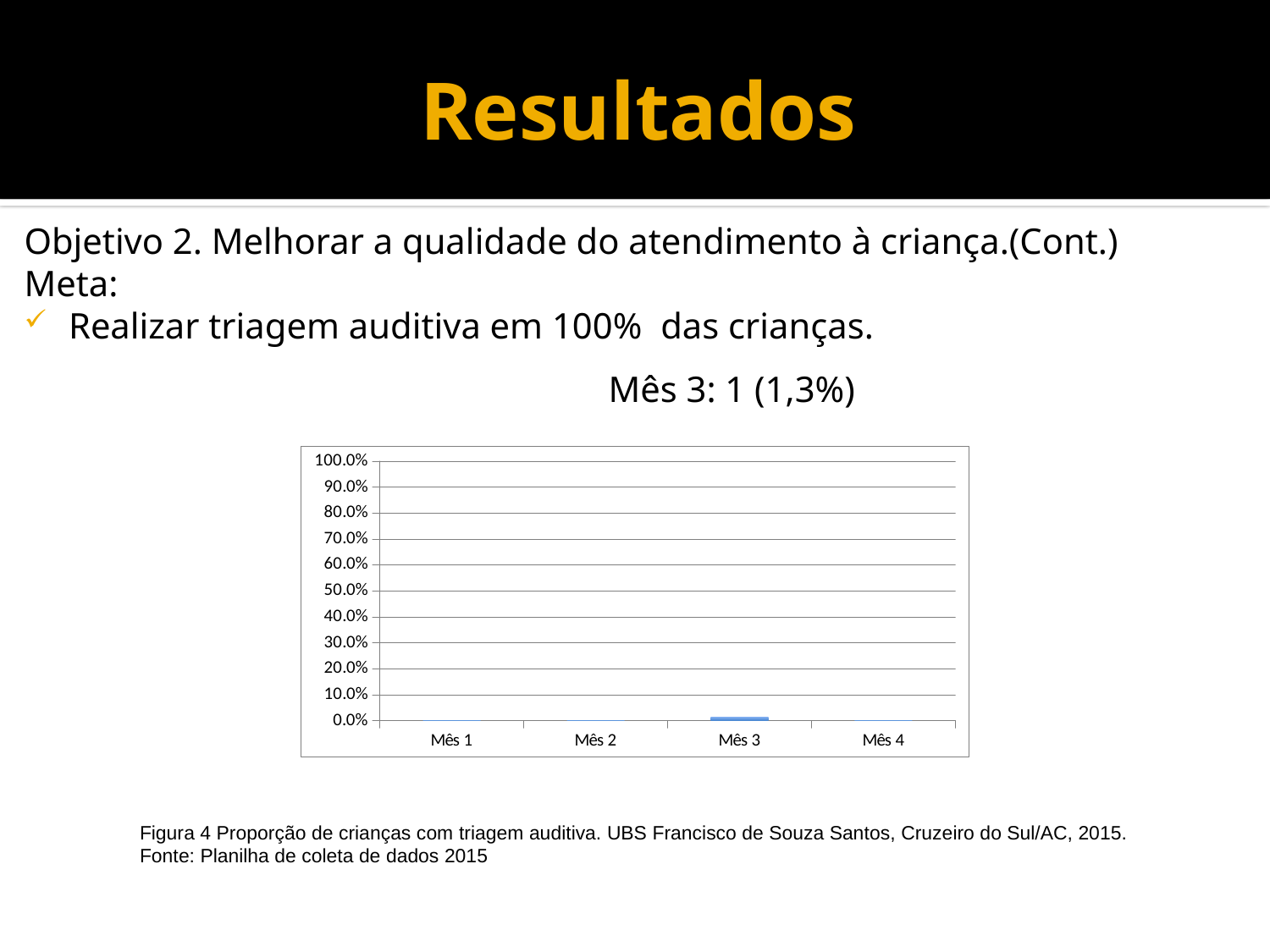
What is the value shown for Mês 4 in the chart? 0.0% Is the value for Mês 3 greater or less than 10.0%? less Which month has the highest value in the chart? Mês 3 Is the value for Mês 2 greater or less than 10.0%? less What is the figure caption number given below the chart? Figura 4 Which is larger, the value for Mês 2 or the value for Mês 3? Mês 3 What kind of chart is shown on the slide? bar chart What is the highest value shown on the y axis of the chart? 100.0% How many categories are shown on the x axis of the chart? 4 What is the value shown for Mês 1 in the chart? 0.0% According to the text above the chart, what percentage is reported for Mês 3? 1,3%